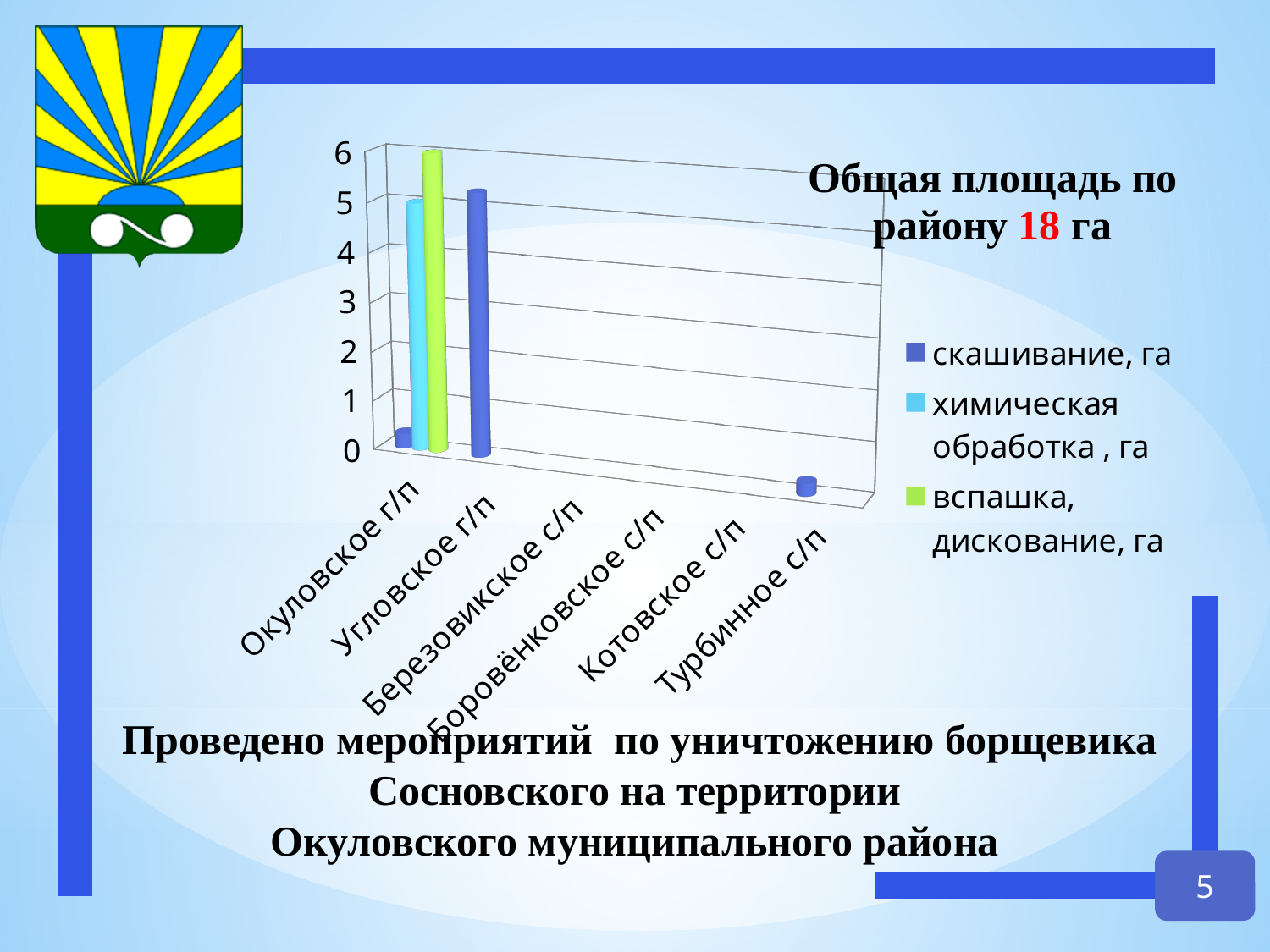
How many categories are shown on the x axis of the chart? 6 Is the value of скашивание, га for Окуловское г/п greater or less than 1? less Which category has the highest value for скашивание, га? Угловское г/п Which is larger: вспашка, дискование, га for Окуловское г/п or скашивание, га for Угловское г/п? вспашка, дискование, га for Окуловское г/п Which series has the highest value for Окуловское г/п? вспашка, дискование, га What total area for the district is stated next to the chart? 18 га Is the value of скашивание, га for Угловское г/п greater or less than 3? greater How many series does the chart legend list? 3 What kind of chart is shown on the slide? bar chart What colour represents the series скашивание, га in the legend? dark blue Is the value of вспашка, дискование, га for Окуловское г/п greater or less than 4? greater